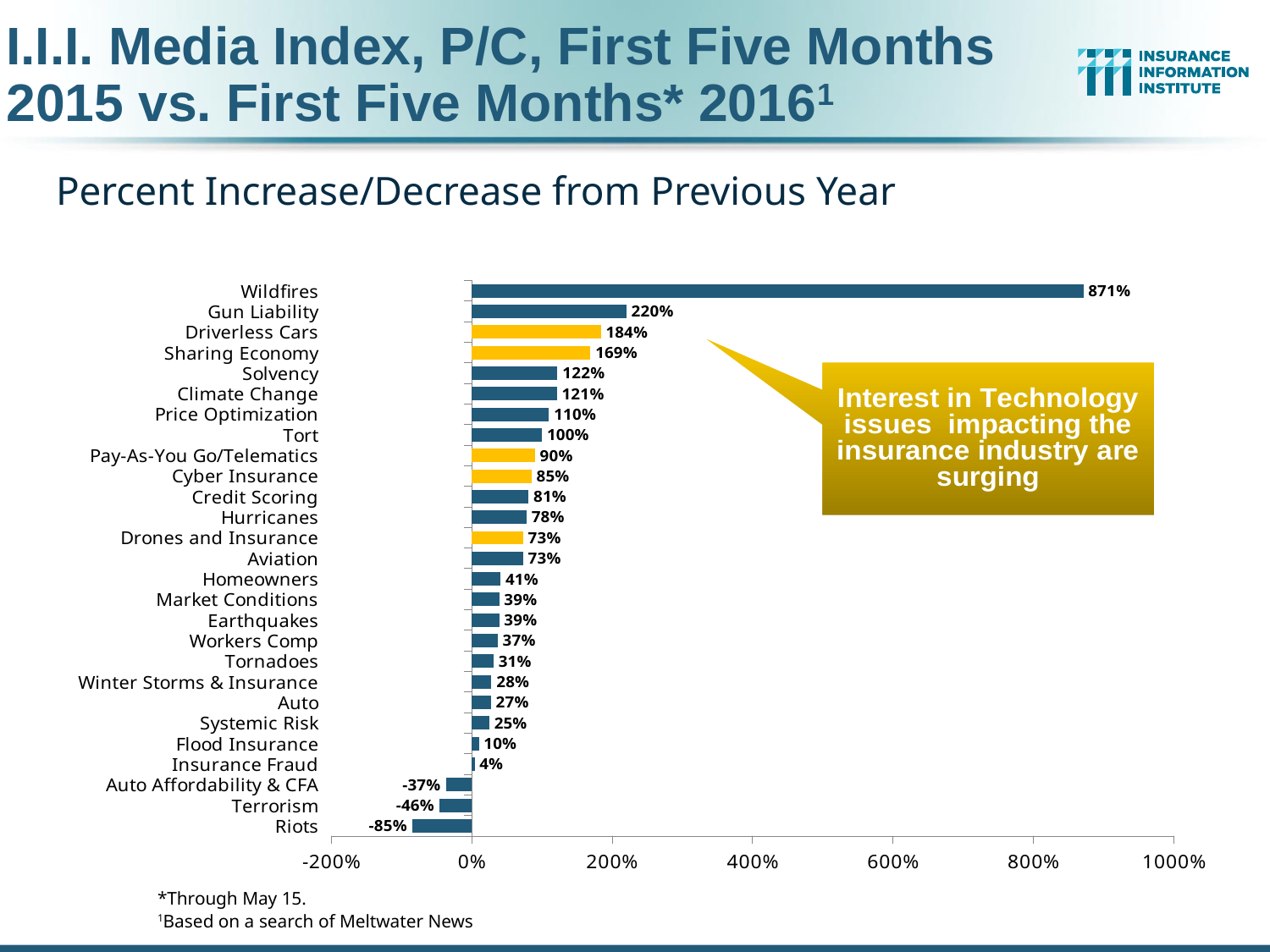
What is the value for Wildfires? 871% What is the value for Cyber Insurance? 85% What is the value for Terrorism? -46% Which category has the lowest value? Riots Which category has the highest value? Wildfires How many categories are shown in the chart? 27 Which is larger, the value for Solvency or the value for Tort? Solvency Is the value for Wildfires greater or less than 800%? greater How many bars are coloured yellow rather than blue? 5 What does the callout box on the chart say? Interest in Technology issues impacting the insurance industry are surging What is the difference between the values for Gun Liability and Driverless Cars? 36% What kind of chart is shown on the slide? bar chart